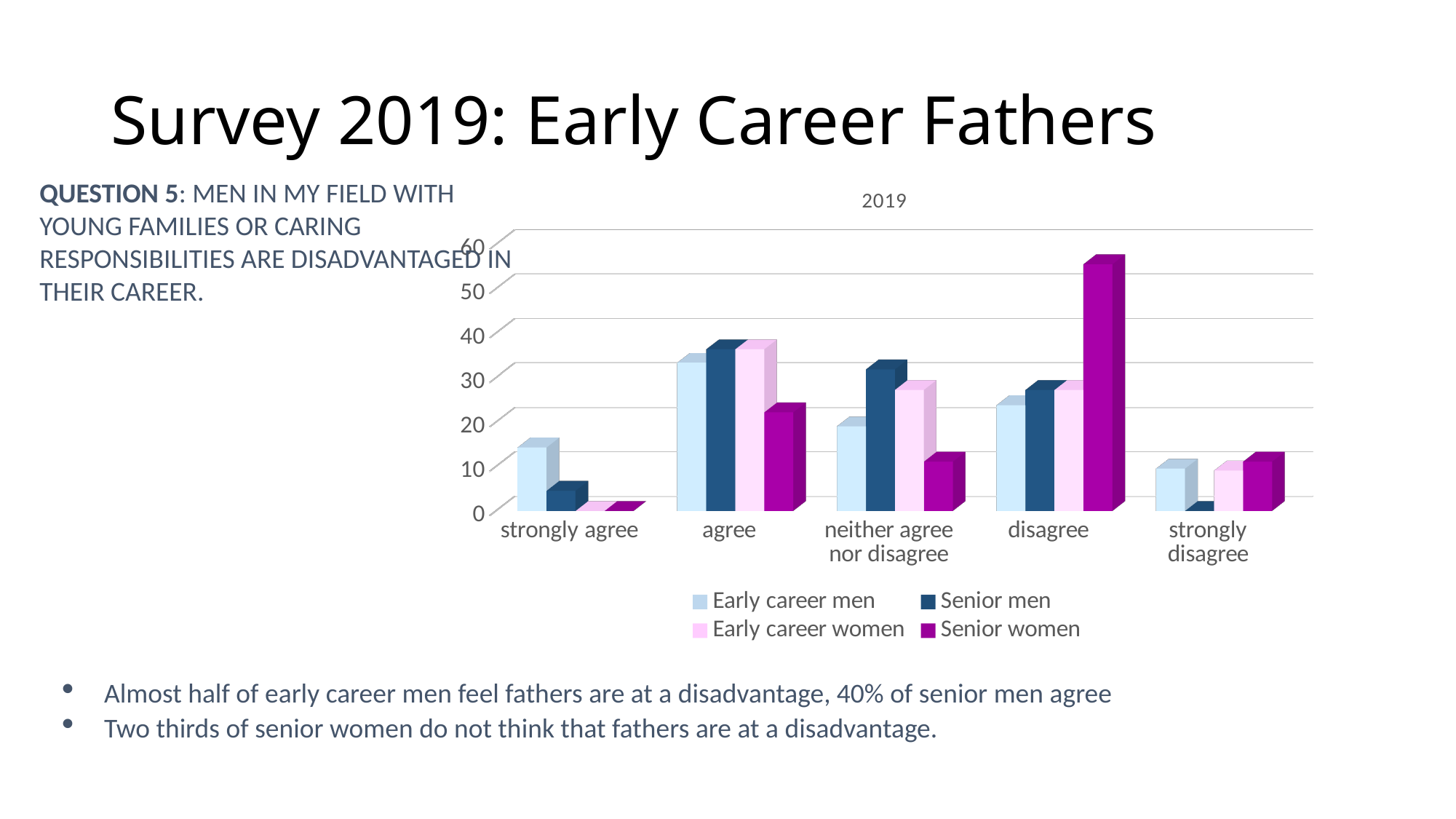
What kind of chart is shown on the slide? bar chart How many series does the chart's legend list? 4 Is the value for Senior women at 'disagree' greater or less than 50? greater At 'agree', which is larger: the value for Senior men or the value for Senior women? Senior men For which response category is the Senior women bar highest? disagree How many response categories are shown on the x axis of the chart? 5 Is the value for Senior women at 'neither agree nor disagree' greater or less than 20? less Is the value for Early career men at 'strongly agree' greater or less than 10? greater For which response category is the Senior men bar lowest? strongly disagree What is the title of the chart? 2019 At 'strongly agree', which is larger: the value for Early career men or the value for Senior men? Early career men